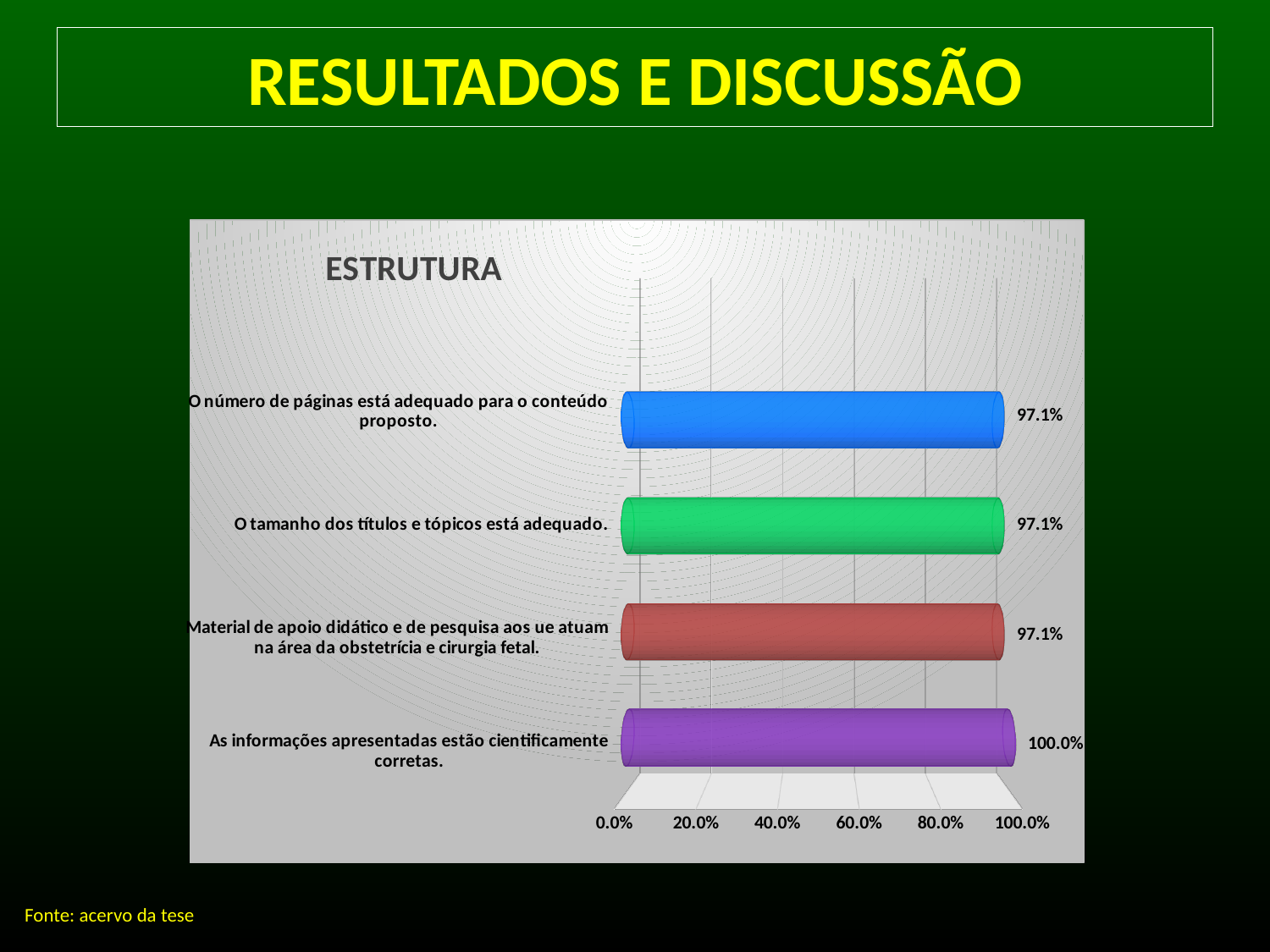
What is the value for "O número de páginas está adequado para o conteúdo proposto."? 97.1% What is the value for "As informações apresentadas estão cientificamente corretas."? 100.0% What is the difference between the value for "As informações apresentadas estão cientificamente corretas." and the value for "O tamanho dos títulos e tópicos está adequado."? 2.9% What is the value for "Material de apoio didático e de pesquisa aos ue atuam na área da obstetrícia e cirurgia fetal."? 97.1% Which category has the highest value? As informações apresentadas estão cientificamente corretas. What is the title of the chart? ESTRUTURA What is the value for "O tamanho dos títulos e tópicos está adequado."? 97.1% Which is larger: the value for "As informações apresentadas estão cientificamente corretas." or the value for "O número de páginas está adequado para o conteúdo proposto."? As informações apresentadas estão cientificamente corretas. How many categories are shown in the chart? 4 What colour is the bar for "As informações apresentadas estão cientificamente corretas."? purple What kind of chart is shown on the slide? bar chart Is the value for "O tamanho dos títulos e tópicos está adequado." greater or less than 80.0%? greater